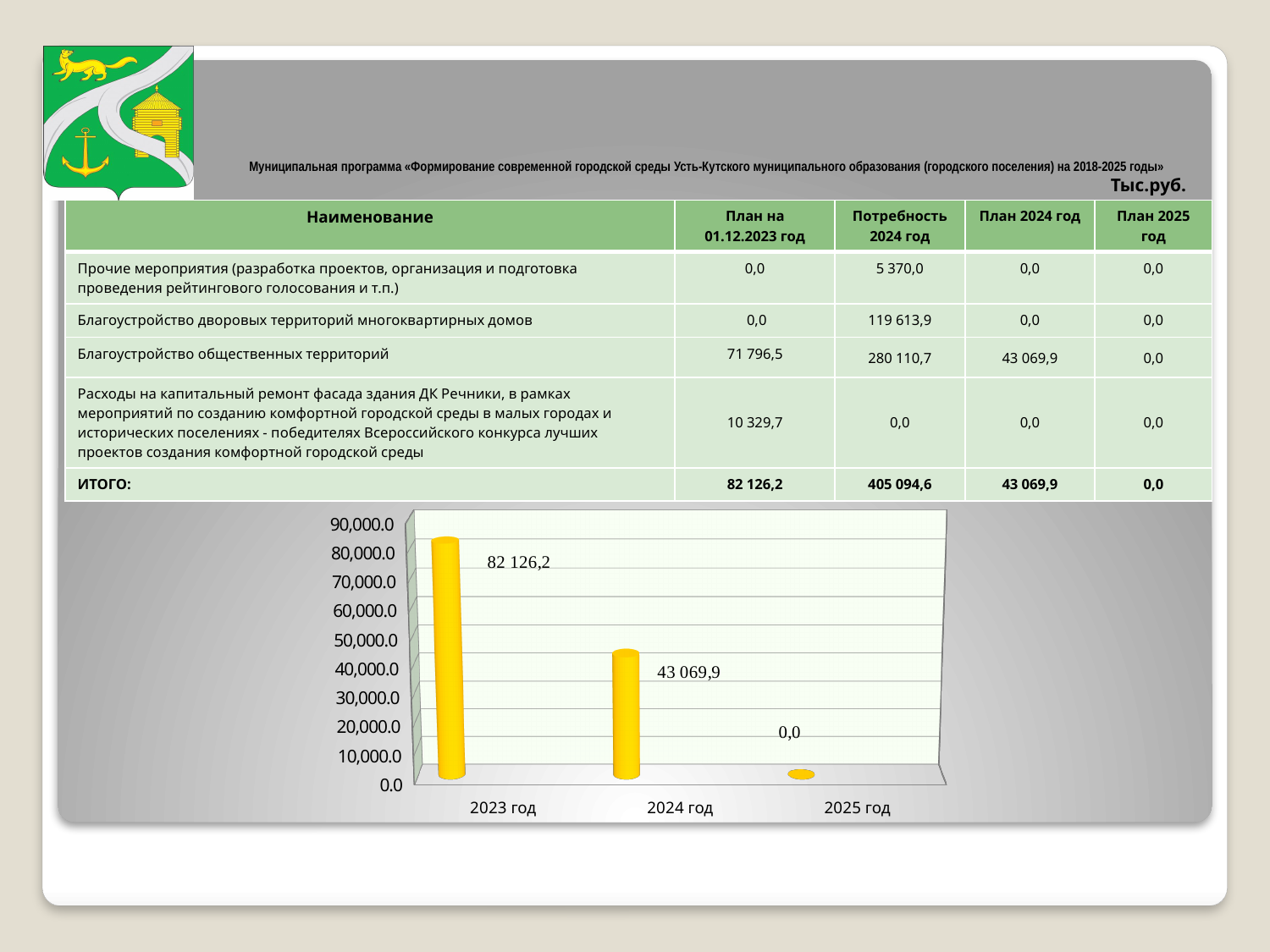
Which year has the highest value in the chart? 2023 год How many categories are shown on the x axis of the chart? 3 What kind of chart is shown on the slide? bar chart Is the value for 2024 год in the chart greater or less than 50,000.0? less Which year has the lowest value in the chart? 2025 год What is the value shown for 2024 год in the chart? 43 069,9 Do the values in the chart rise or fall from 2023 год to 2025 год? fall Which is larger in the chart, the value for 2023 год or the value for 2024 год? 2023 год What is the value shown for 2023 год in the chart? 82 126,2 What is the value shown for 2025 год in the chart? 0,0 Is the value for 2023 год in the chart greater or less than 80,000.0? greater What is the difference between the values for 2023 год and 2024 год in the chart? 39 056,3